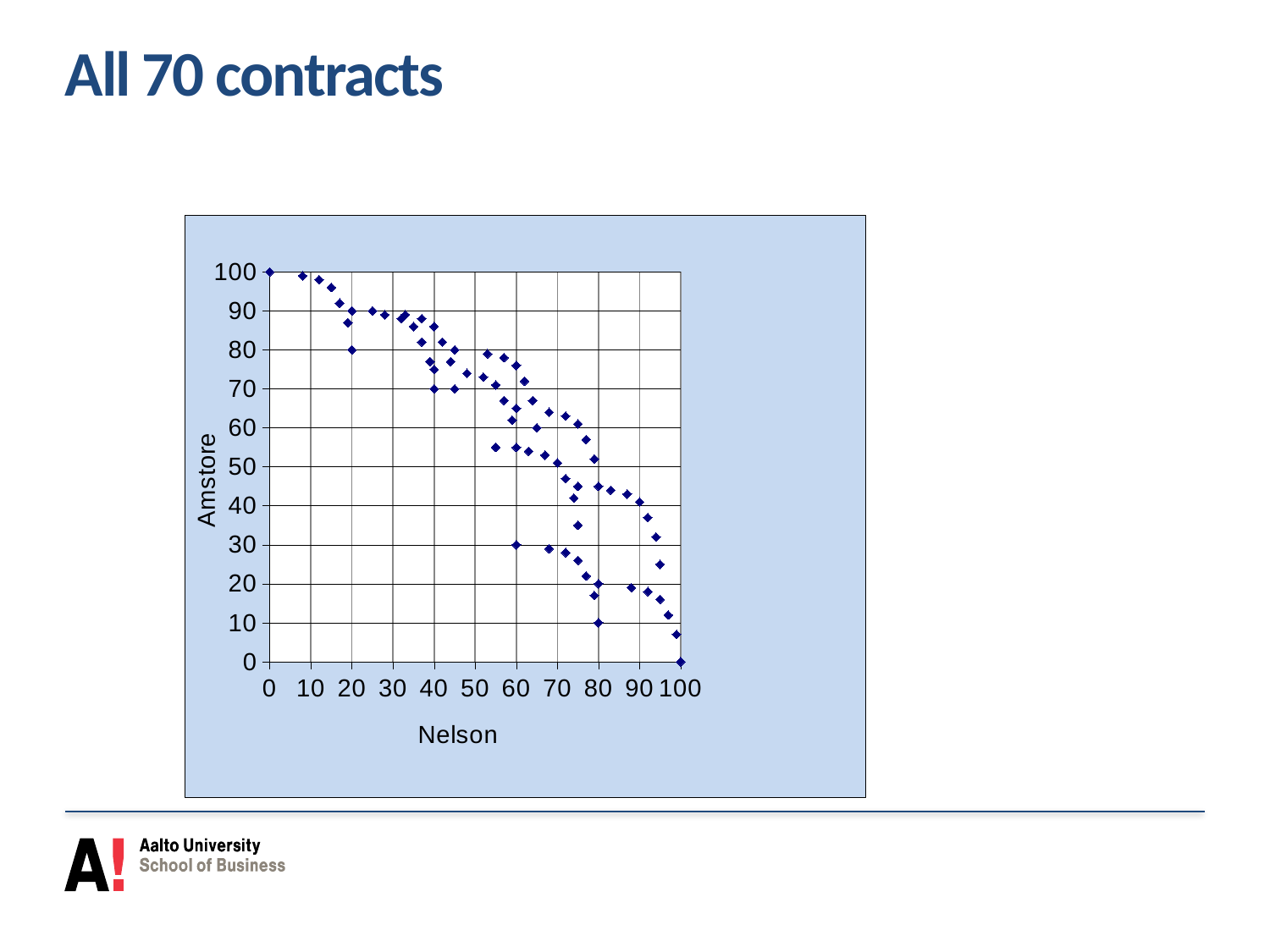
What is the Amstore value of the lowest point plotted at Nelson 20? 80 What is the Amstore value of the point plotted at Nelson 0? 100 Is the Amstore value of the lowest point plotted at Nelson 100 greater or less than 50? less What is the lowest Amstore value plotted in the chart? 0 Which has the larger Amstore value: the point at Nelson 0 or the lowest point at Nelson 100? the point at Nelson 0 As the Nelson value increases along the x axis, do the Amstore values generally rise or fall? fall What is the label of the vertical axis of the chart? Amstore Is the Amstore value of the point plotted at Nelson 0 greater or less than 50? greater What is the highest Amstore value plotted in the chart? 100 What is the label of the horizontal axis of the chart? Nelson According to the slide title, how many contracts are plotted in the chart? 70 What kind of chart is shown on the slide? scatter chart